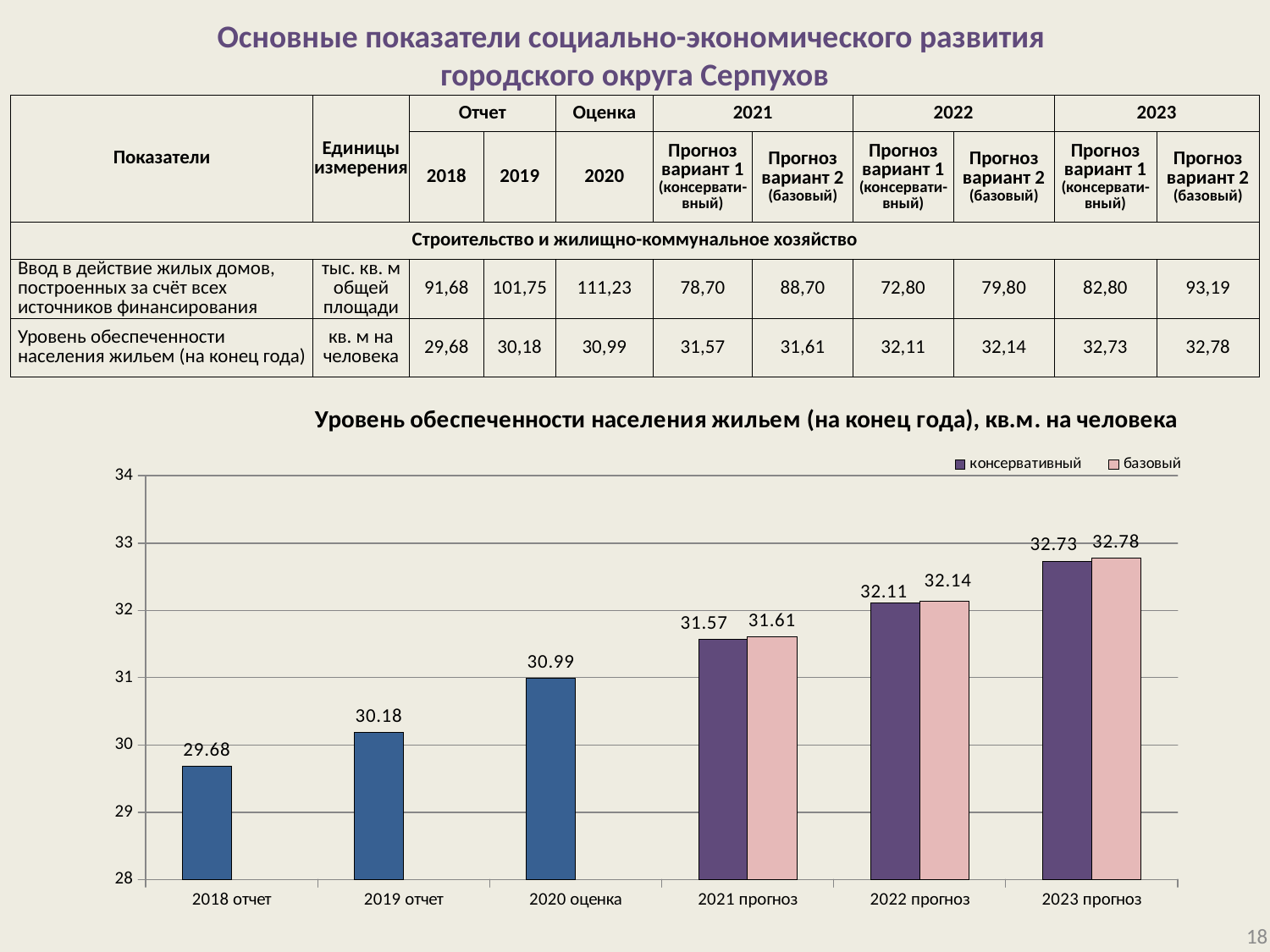
What is the difference between the 2020 оценка value and the 2019 отчет value? 0.81 How many categories are shown on the x axis of the chart? 6 For 2023 прогноз, how much higher is the базовый value than the консервативный value? 0.05 Is the value for 2018 отчет greater or less than 30? less What is the value for 2018 отчет in the chart? 29.68 What is the базовый value for 2022 прогноз? 32.14 What is the консервативный value for 2023 прогноз? 32.73 How many series does the chart legend list? 2 Do the values rise or fall from 2018 отчет to 2023 прогноз? rise Which bar has the highest value in the chart? базовый for 2023 прогноз (32.78) Which is larger: the консервативный value for 2021 прогноз or for 2022 прогноз? 2022 прогноз Which category has the lowest value in the chart? 2018 отчет